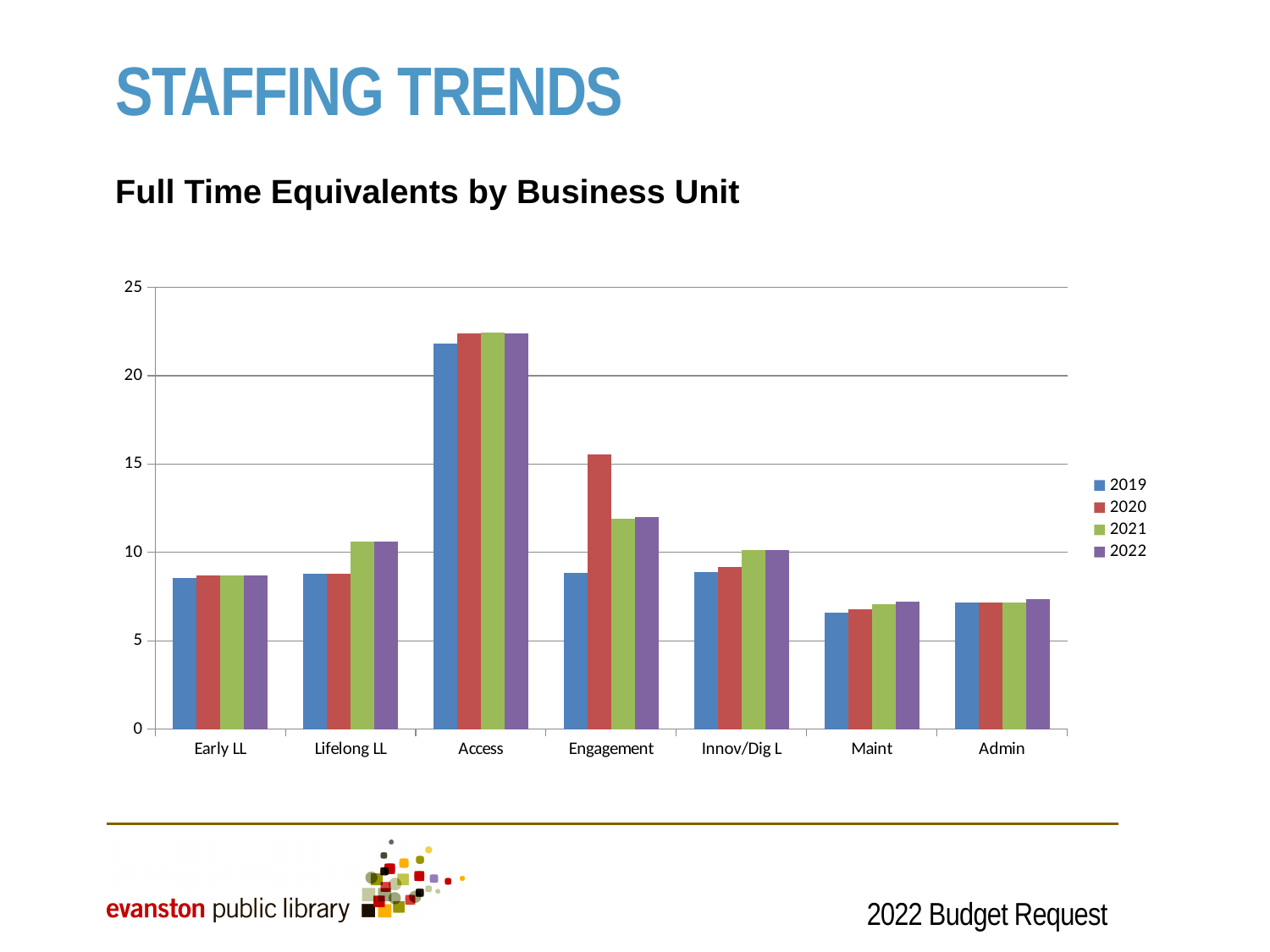
Is the 2019 value for Access greater or less than 20? greater For Engagement, which year has the larger value: 2019 or 2020? 2020 Which business unit has the highest number of full time equivalents in 2020? Access Is the 2021 value for Admin greater or less than 10? less Is the 2022 value for Early LL greater or less than 10? less Which business unit has the lowest number of full time equivalents in 2019? Maint What is the title of the chart? Full Time Equivalents by Business Unit How many business units are shown on the x axis of the chart? 7 In 2021, which has the larger value: Early LL or Lifelong LL? Lifelong LL What type of chart is shown on the slide? Bar chart How many series does the chart legend list? 4